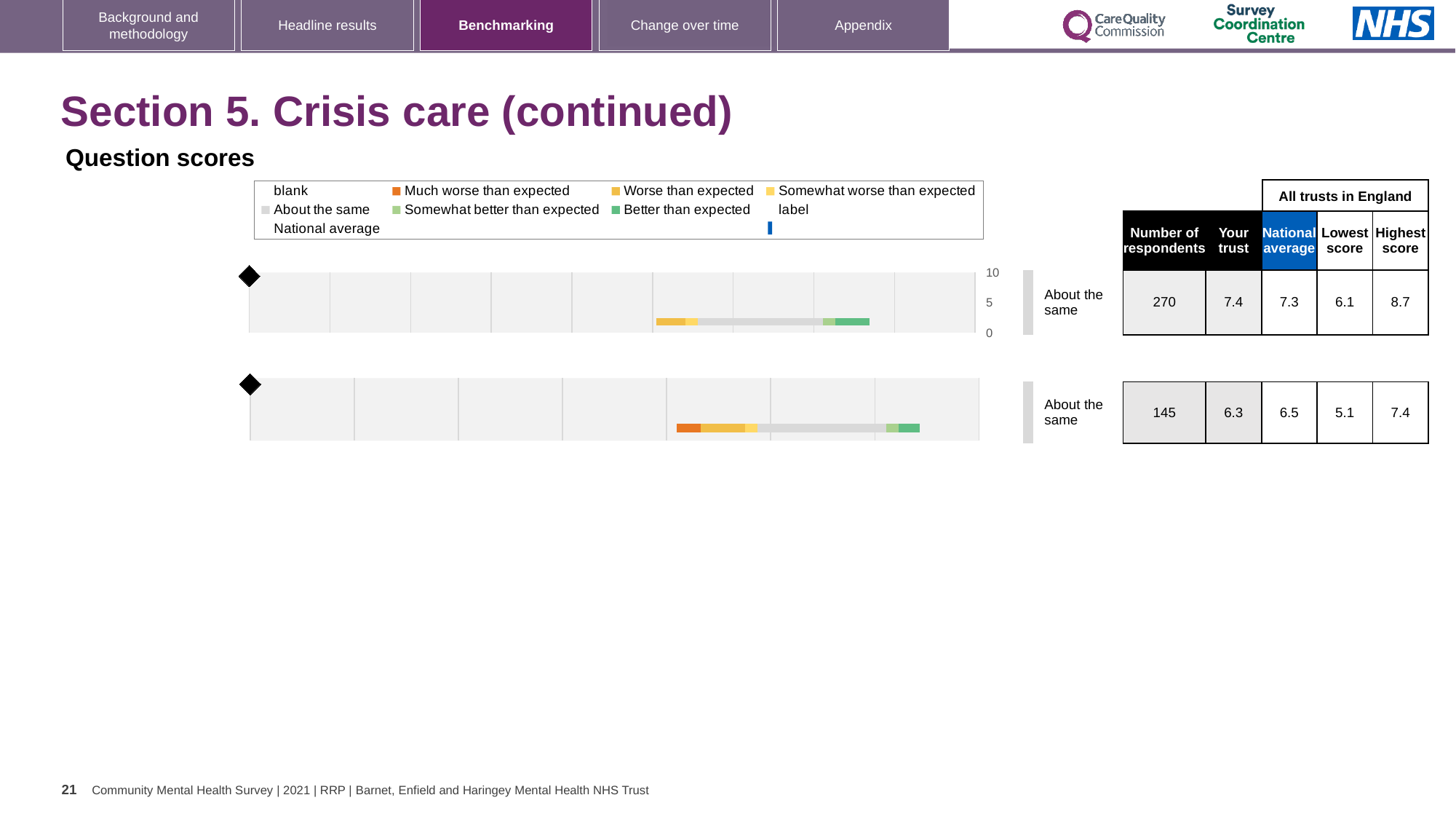
For the bottom chart, what is the highest score among all trusts in England? 7.4 For the bottom chart, what is the 'Your trust' score? 6.3 For the top chart, which is larger: the 'Your trust' score or the national average? Your trust For the top chart, what is the number of respondents shown in the table? 270 In the legend, which colour represents 'Much worse than expected'? Orange For the bottom chart, which is larger: the 'Your trust' score or the national average? National average What kind of chart is used to show the question scores on this slide? bar chart For the top chart, what is the difference between the highest score (8.7) and the lowest score (6.1)? 2.6 What benchmark rating label is shown next to the bottom chart? About the same For the top chart, what is the 'Your trust' score? 7.4 How many question score charts are shown on the slide? 2 For the top chart, what is the national average score? 7.3